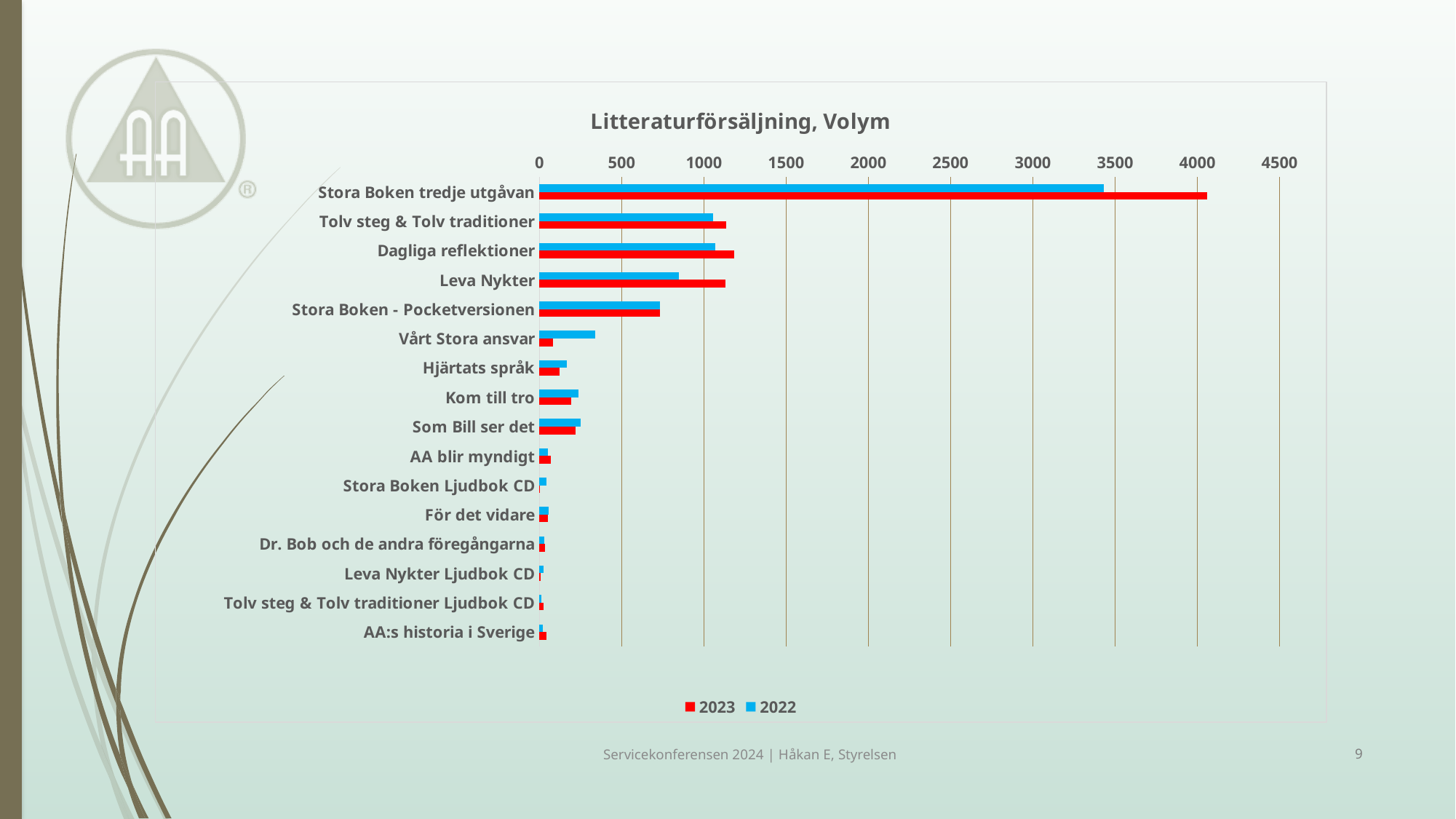
For Vårt Stora ansvar, which year has the larger value, 2023 or 2022? 2022 Is the 2023 value for Tolv steg & Tolv traditioner greater or less than 1000? greater What kind of chart is shown on the slide? Bar chart Is the 2022 value for Stora Boken tredje utgåvan greater or less than 3000? greater Which category has the highest 2023 value? Stora Boken tredje utgåvan What is the title of the chart? Litteraturförsäljning, Volym How many categories (titles) are shown on the chart? 16 How many series does the legend list? 2 Is the 2022 value for Vårt Stora ansvar greater or less than 500? less For Leva Nykter, which year has the larger value, 2023 or 2022? 2023